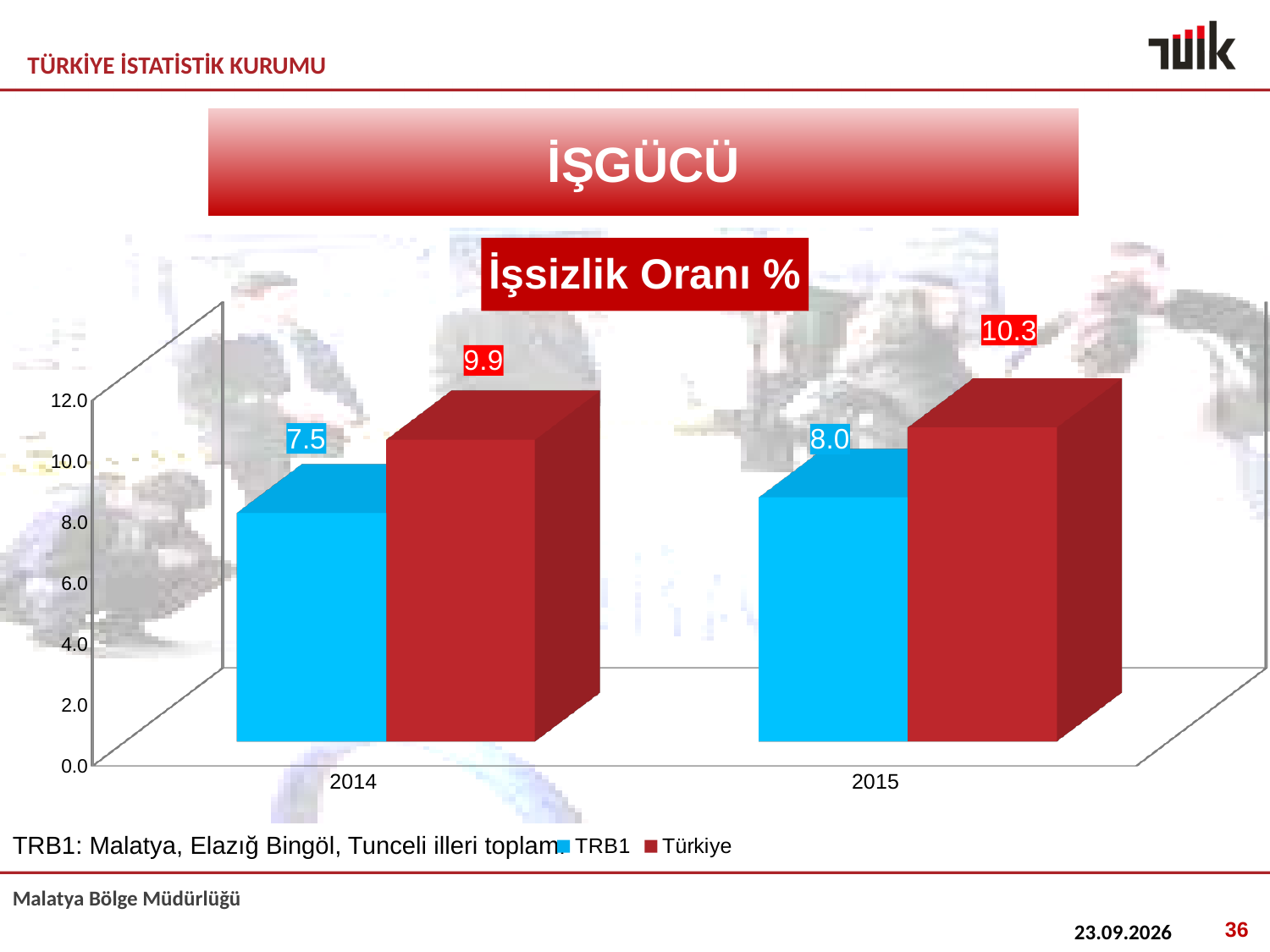
What is the unemployment rate for Türkiye in 2015? 10.3 What kind of chart is shown on the slide? bar chart What is the unemployment rate for Türkiye in 2014? 9.9 What is the unemployment rate for TRB1 in 2014? 7.5 Does the TRB1 unemployment rate rise or fall from 2014 to 2015? rise How many series does the legend list? 2 Is the TRB1 unemployment rate in 2015 greater or less than the Türkiye rate in 2015? less What is the unemployment rate for TRB1 in 2015? 8.0 Which series has the highest value in 2015? Türkiye How many years are shown on the x axis? 2 Which bar shows the lowest value on the chart? TRB1 in 2014 What is the difference between the Türkiye and TRB1 unemployment rates in 2014? 2.4